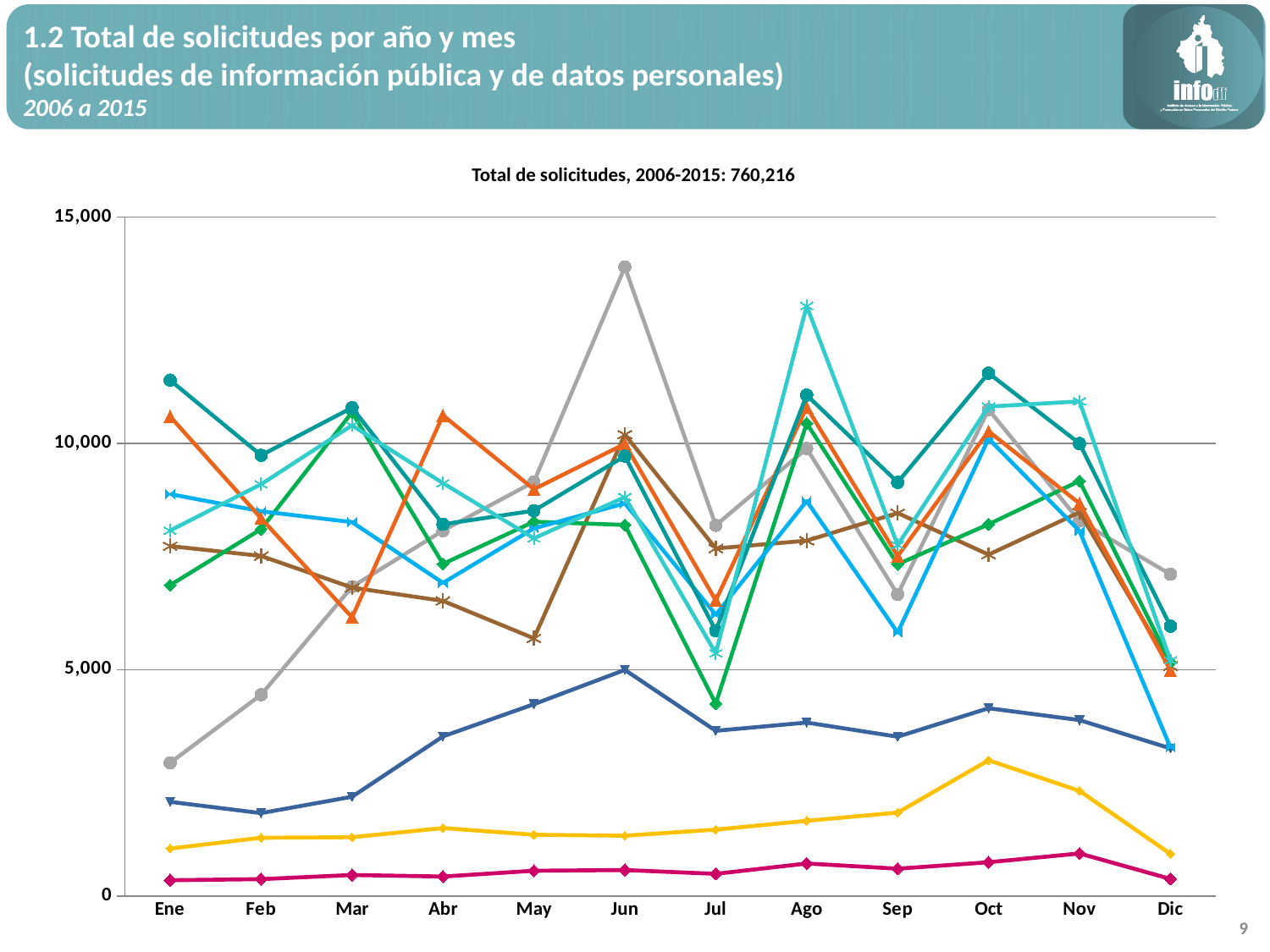
In which month does the gray line have its lowest value? Ene According to the chart title, what is the total number of solicitudes for 2006-2015? 760,216 In which month does the gray line reach its highest value? Jun What is the title printed above the chart? Total de solicitudes, 2006-2015: 760,216 How many months are shown along the x axis of the chart? 12 What kind of chart is shown on the slide? line chart In which month does the yellow line reach its highest value? Oct Is the value of the gray line in Jun greater or less than 10,000? greater Does the yellow line rise or fall from Oct to Dic? fall Which is larger for the gray line: the value in Jun or the value in Ene? Jun Is the value of the magenta line in Oct greater or less than 5,000? less Is the value of the yellow line in Dic greater or less than 5,000? less